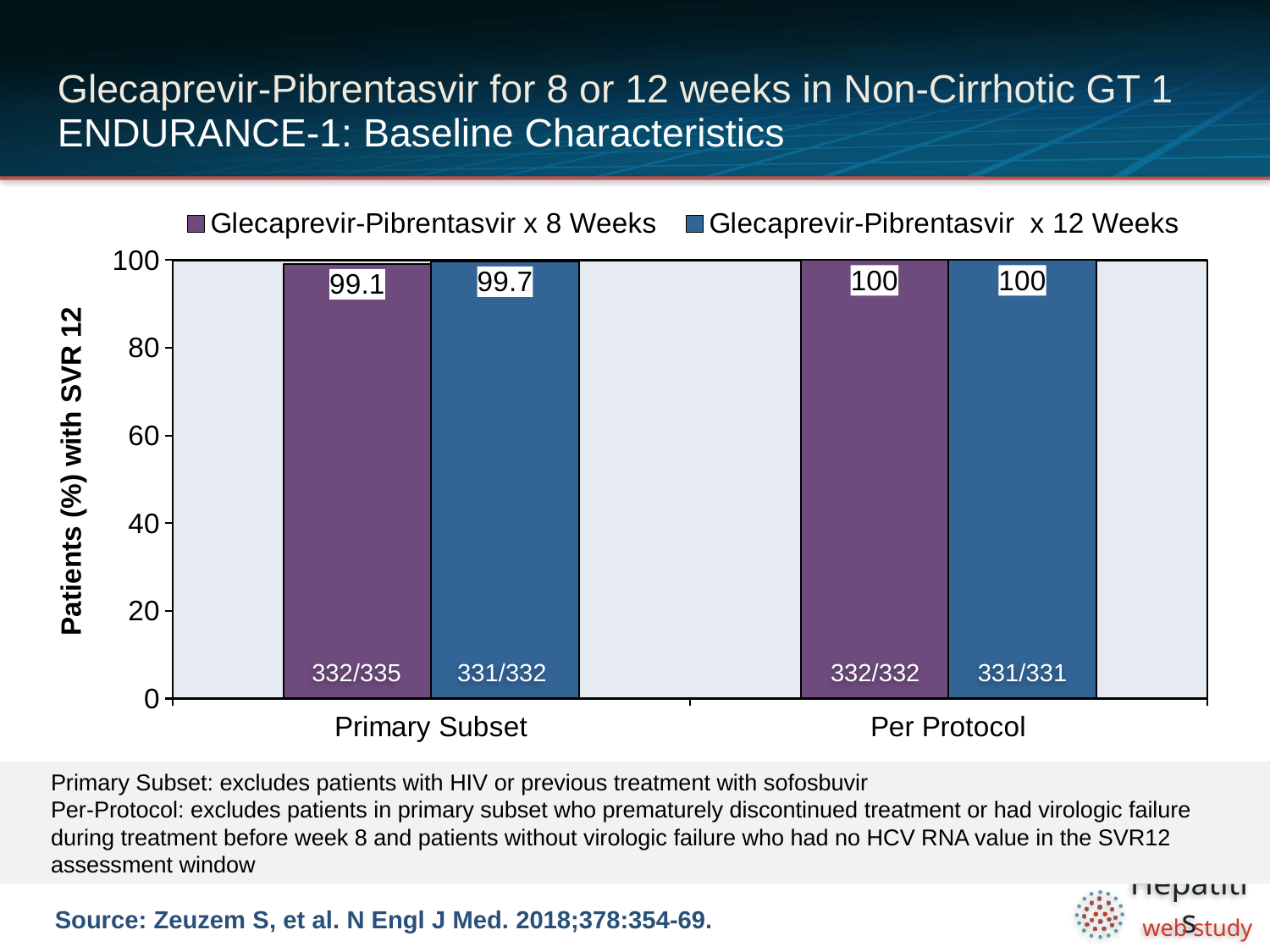
What is the SVR12 rate for Glecaprevir-Pibrentasvir x 8 Weeks in the Per Protocol group? 100 What kind of chart is shown on the slide? Bar chart What is the difference between the 12-week and 8-week SVR12 rates in the Primary Subset? 0.6 What is the SVR12 rate for Glecaprevir-Pibrentasvir x 12 Weeks in the Primary Subset? 99.7 How many categories are shown on the x axis? 2 What is the SVR12 rate for Glecaprevir-Pibrentasvir x 8 Weeks in the Primary Subset? 99.1 What fraction of patients is shown for Glecaprevir-Pibrentasvir x 12 Weeks in the Per Protocol group? 331/331 Which colour represents Glecaprevir-Pibrentasvir x 12 Weeks in the legend? Blue In the Primary Subset, which regimen has the higher SVR12 rate, 8 weeks or 12 weeks? Glecaprevir-Pibrentasvir x 12 Weeks How many series does the legend list? 2 What is the label of the y axis? Patients (%) with SVR 12 What fraction of patients is shown for Glecaprevir-Pibrentasvir x 8 Weeks in the Primary Subset? 332/335